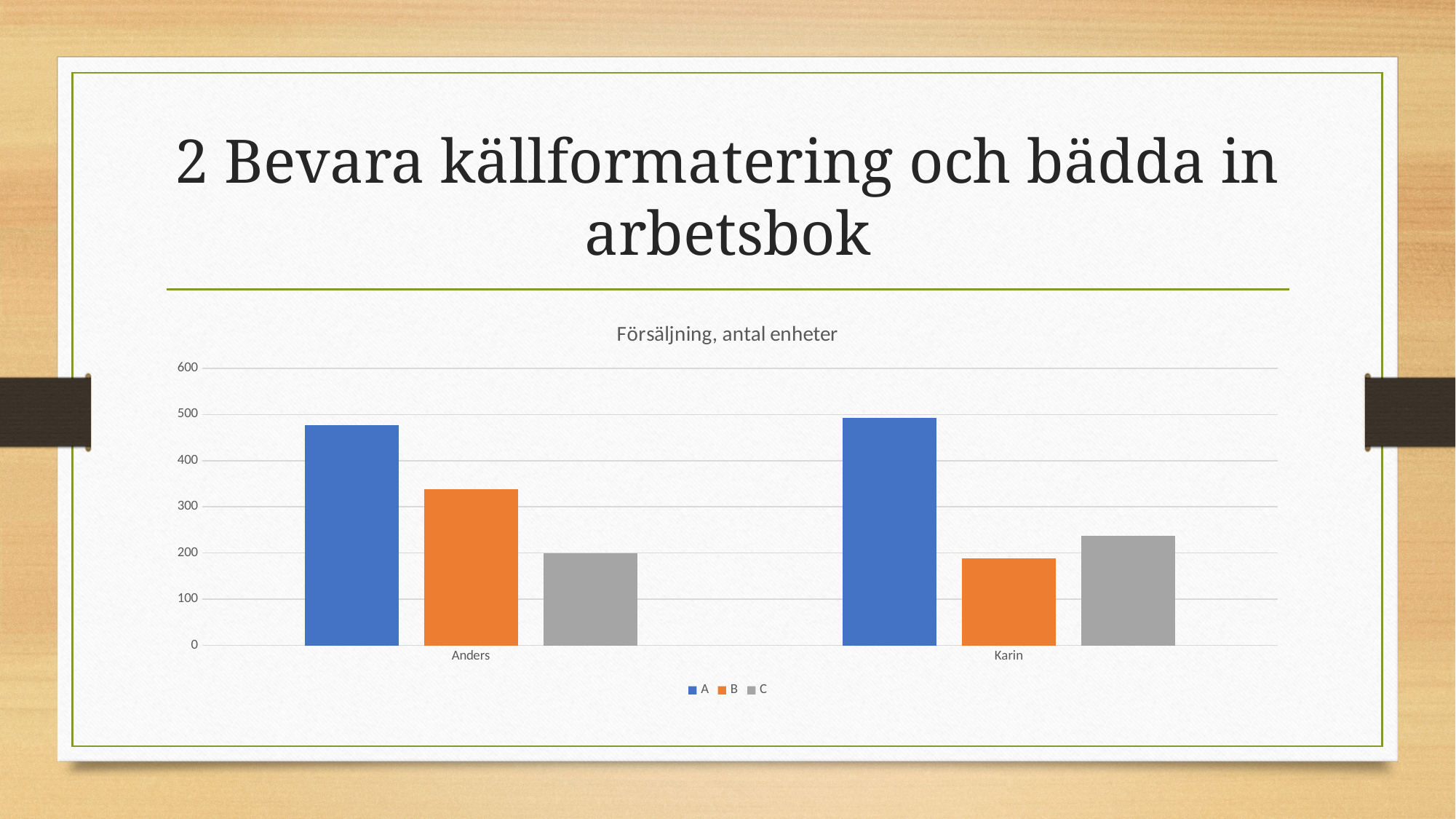
Which series has the lowest value for Anders? C Which series has the lowest value for Karin? B Is the value of series B for Anders greater or less than 300? greater Which is larger: series C for Anders or series C for Karin? Karin How many categories are shown on the x axis? 2 Which series has the highest value for Anders? A Which is larger: series B for Anders or series B for Karin? Anders Is the value of series C for Karin greater or less than 200? greater Is the value of series A for Anders greater or less than 400? greater What type of chart is shown on the slide? Bar chart What is the title of the chart? Försäljning, antal enheter How many series does the legend list? 3